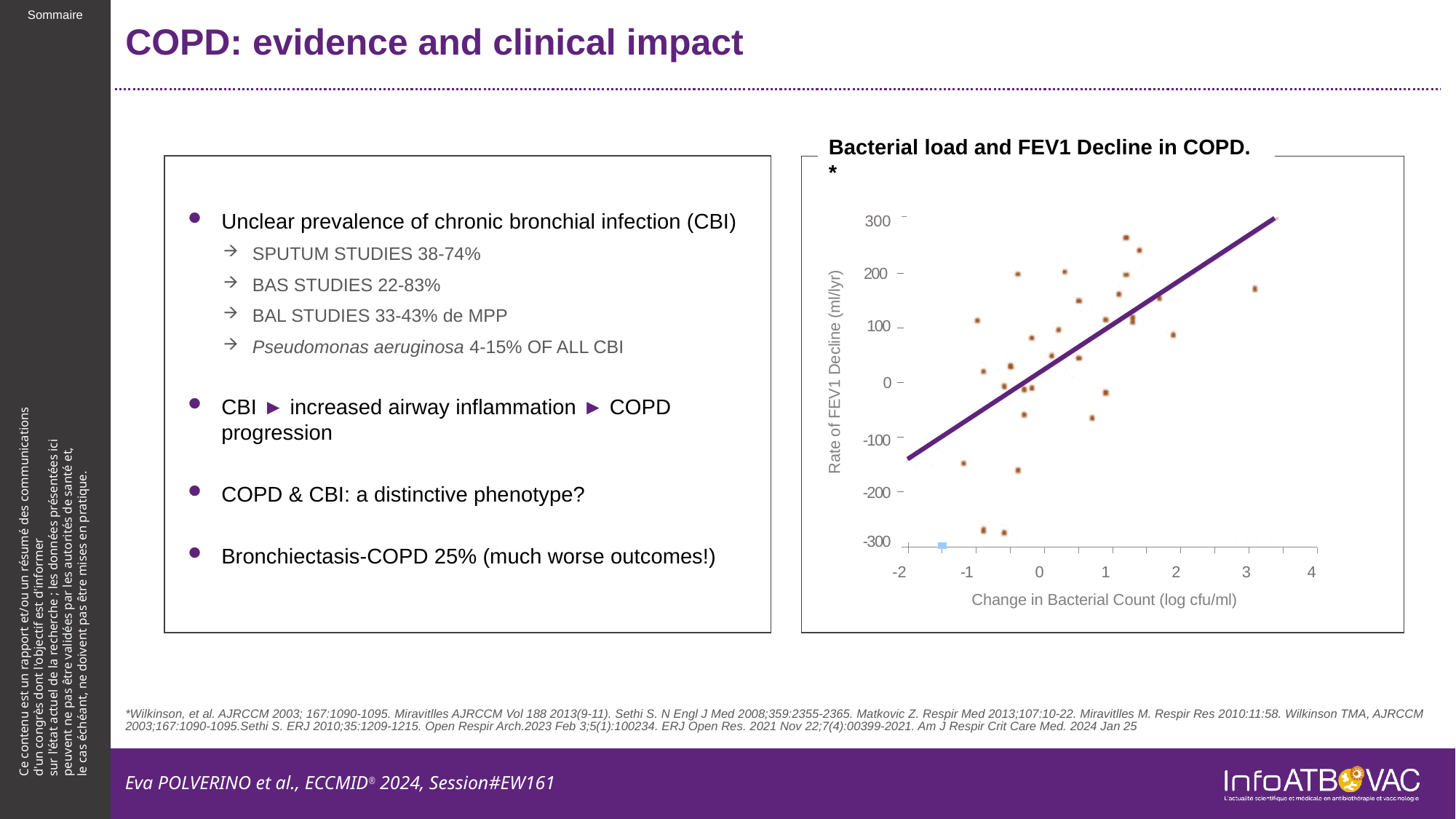
What is the label of the x axis of the chart? Change in Bacterial Count (log cfu/ml) What kind of chart is shown on the slide? scatter chart Does the trend line in the chart rise or fall as the change in bacterial count increases? rise What is the title of the chart? Bacterial load and FEV1 Decline in COPD.* Overall, does the rate of FEV1 decline increase or decrease as the change in bacterial count increases along the x axis? increase